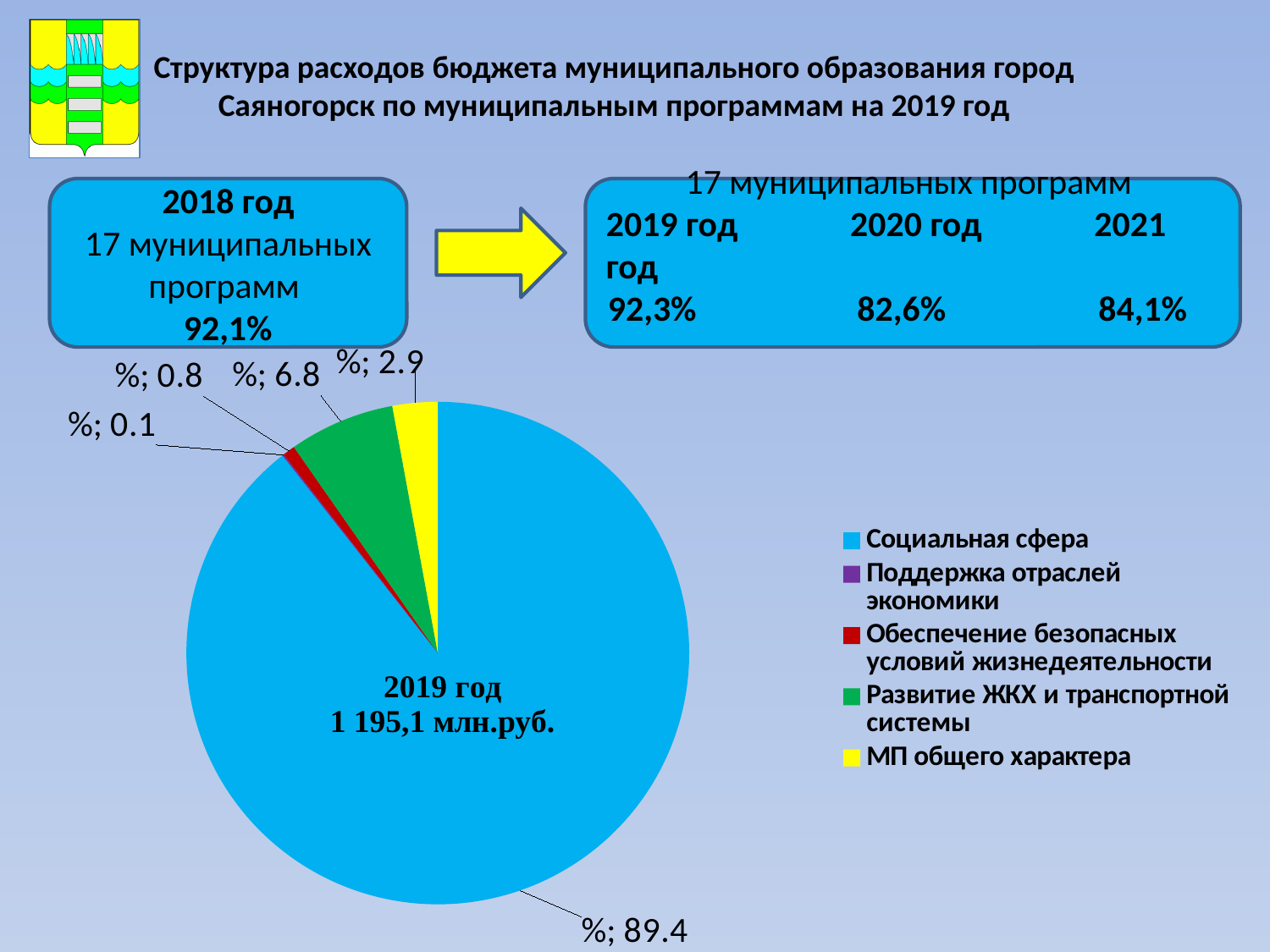
Which is larger: the slice for "Развитие ЖКХ и транспортной системы" or the slice for "МП общего характера"? Развитие ЖКХ и транспортной системы What value is shown for the slice "Развитие ЖКХ и транспортной системы"? 6.8 How many categories does the pie chart legend list? 5 Which category has the smallest slice of the pie? Поддержка отраслей экономики Which category has the largest slice of the pie? Социальная сфера What colour is the slice for "Социальная сфера"? blue What kind of chart is shown on the slide? pie chart What value is shown for the slice "Социальная сфера"? 89.4 What value is shown for the slice "Обеспечение безопасных условий жизнедеятельности"? 0.8 What is the difference between the values for "Развитие ЖКХ и транспортной системы" and "МП общего характера"? 3.9 What value is shown for the slice "МП общего характера"? 2.9 What total amount for 2019 is written in the centre of the pie chart? 1 195,1 млн.руб.